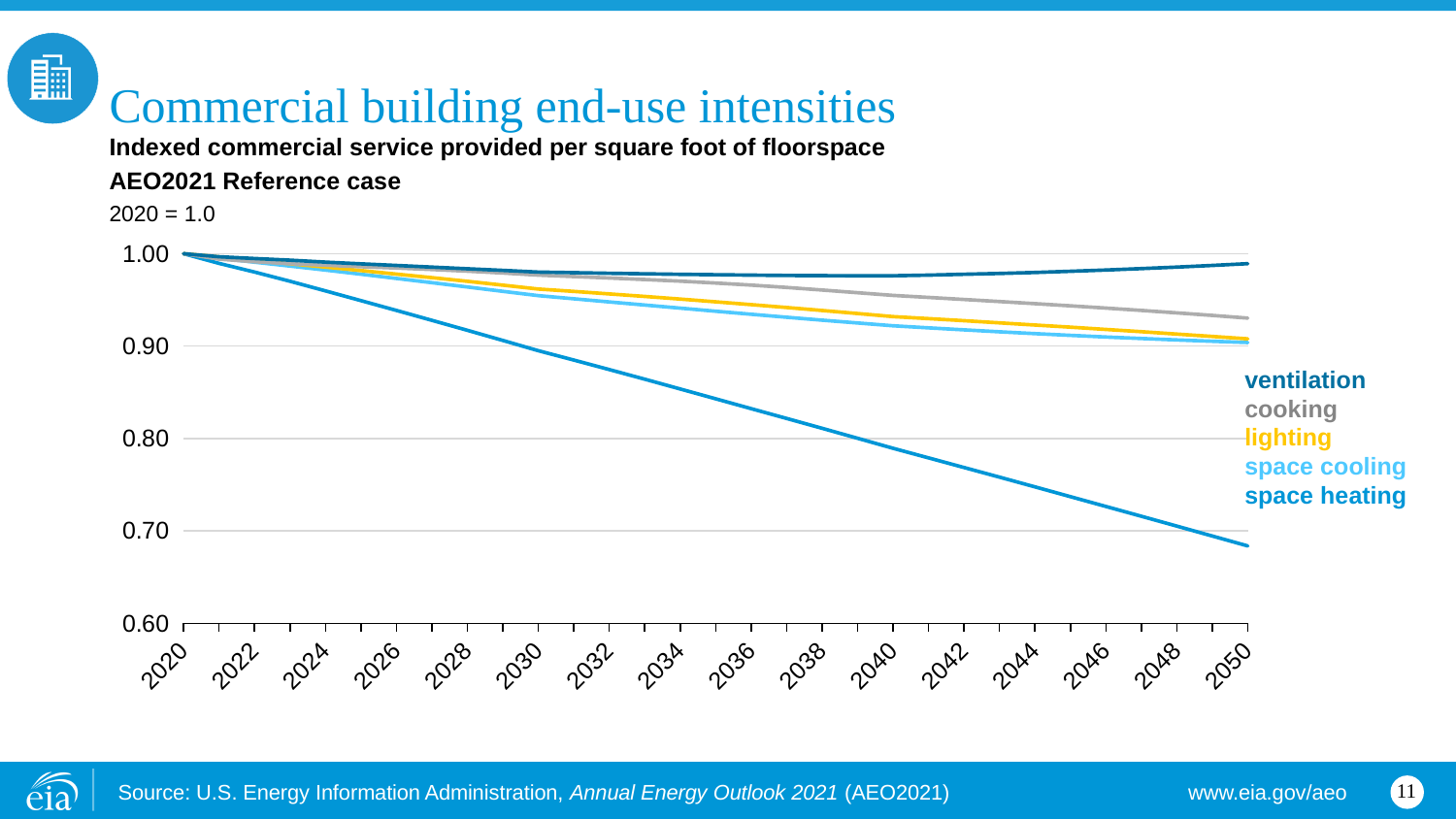
Which series has the lowest value in 2050? space heating Is the value for ventilation in 2050 greater or less than 0.90? greater In 2050, which is larger: cooking or space heating? cooking Is the value for cooking in 2050 greater or less than 0.90? greater What is the title of the chart? Commercial building end-use intensities What is the indexed value of all series in 2020? 1.00 How many series does the chart show? 5 Which series has the highest value in 2050? ventilation Is the value for space heating in 2050 greater or less than 0.70? less What type of chart is shown on the slide? line chart Does the space heating line rise or fall from 2020 to 2050? fall In 2050, which is larger: ventilation or cooking? ventilation